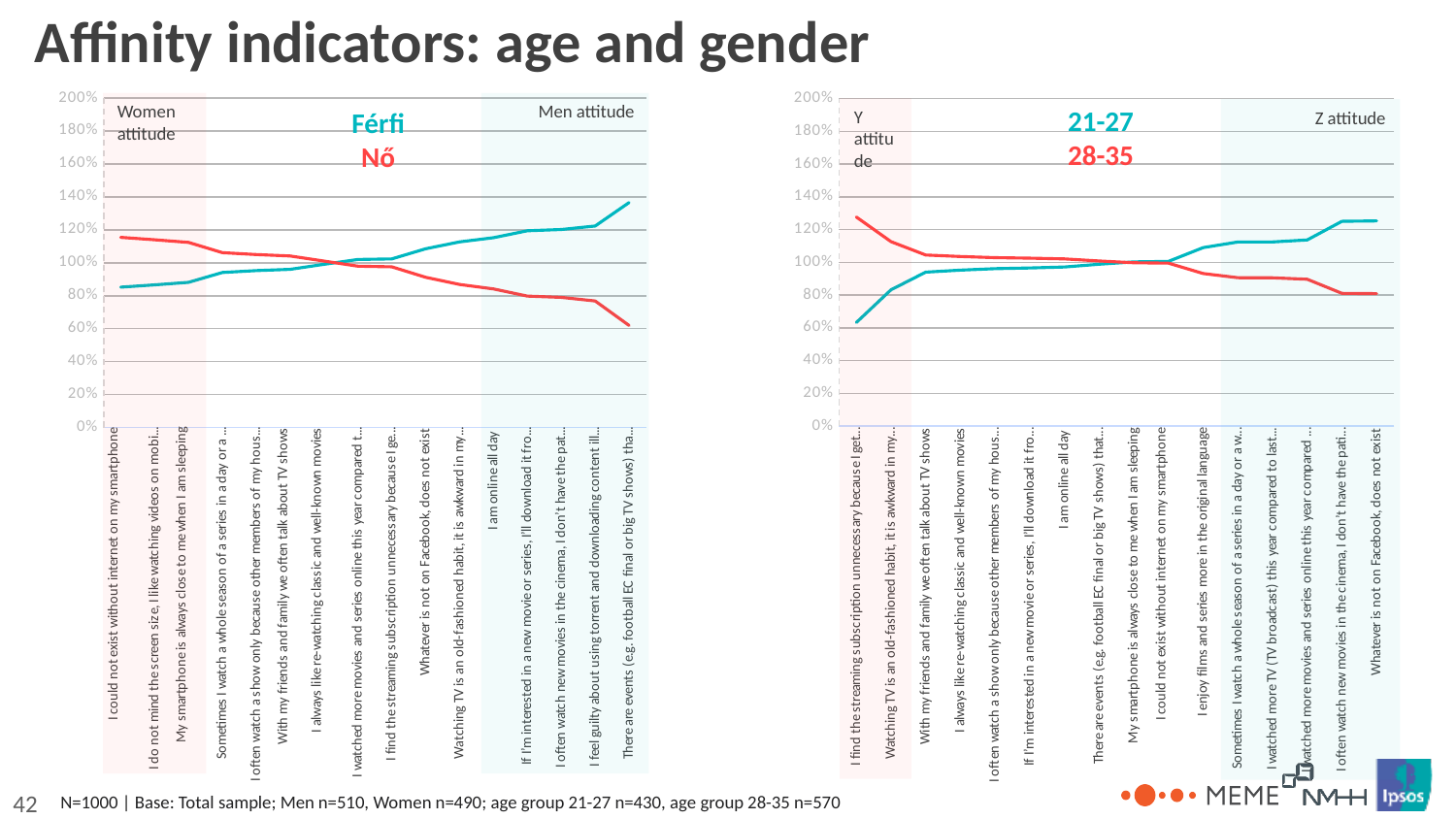
In the left chart (Férfi / Nő), at which category does the Nő line reach its highest value? I could not exist without internet on my smartphone In the right chart (21-27 / 28-35), is the 21-27 value for 'I find the streaming subscription unnecessary because I get...' greater or less than 80%? less How many categories are shown on the x axis of the left chart (Férfi / Nő)? 16 In the right chart (21-27 / 28-35), what label is shown in the shaded region on the right side of the plot? Z attitude In the right chart (21-27 / 28-35), does the 28-35 line rise or fall from left to right along the x axis? fall In the left chart (Férfi / Nő), is the Nő value for 'There are events (e.g. football EC final or big TV shows) tha...' greater or less than 80%? less In the left chart (Férfi / Nő), is the Nő value for 'I could not exist without internet on my smartphone' greater or less than 100%? greater In the left chart (Férfi / Nő), does the Férfi line rise or fall from left to right along the x axis? rise What type of chart is the left chart (Férfi / Nő)? line chart How many series does the right chart (21-27 / 28-35) plot? 2 In the right chart (21-27 / 28-35), which series has the higher value for 'I find the streaming subscription unnecessary because I get...'? 28-35